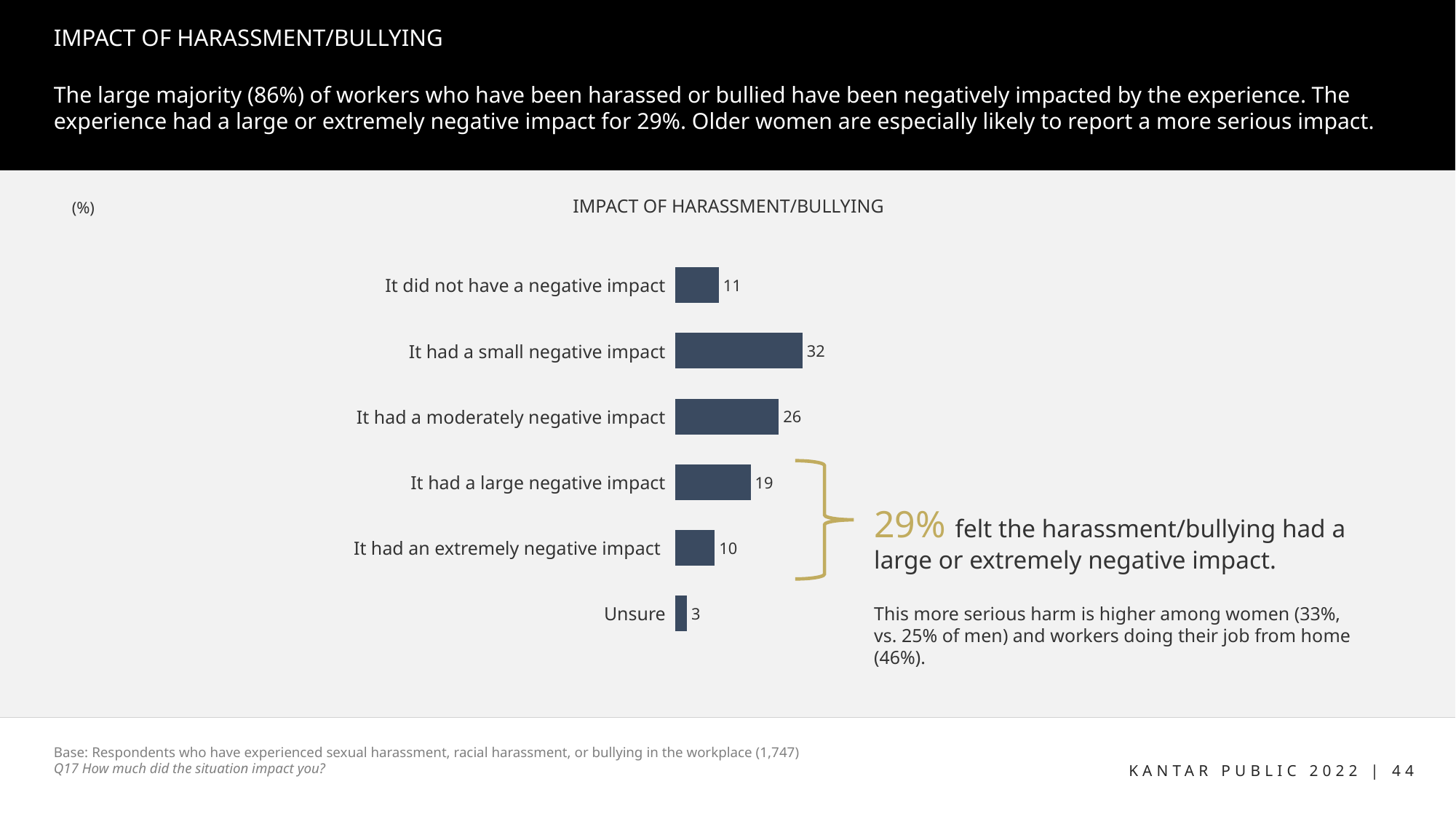
What is the difference between "It had a small negative impact" and "It had a moderately negative impact"? 6 What kind of chart is shown on the slide? Bar chart What is the value for "It had an extremely negative impact"? 10 How many categories are shown in the chart? 6 What is the combined value of "It had a large negative impact" and "It had an extremely negative impact"? 29 Which category has the lowest value? Unsure What unit is indicated for the chart values? % Which is larger: "It had a large negative impact" or "It did not have a negative impact"? It had a large negative impact Which category has the highest value? It had a small negative impact What is the value for "It had a small negative impact"? 32 What is the title of the chart? IMPACT OF HARASSMENT/BULLYING What is the value for "Unsure"? 3